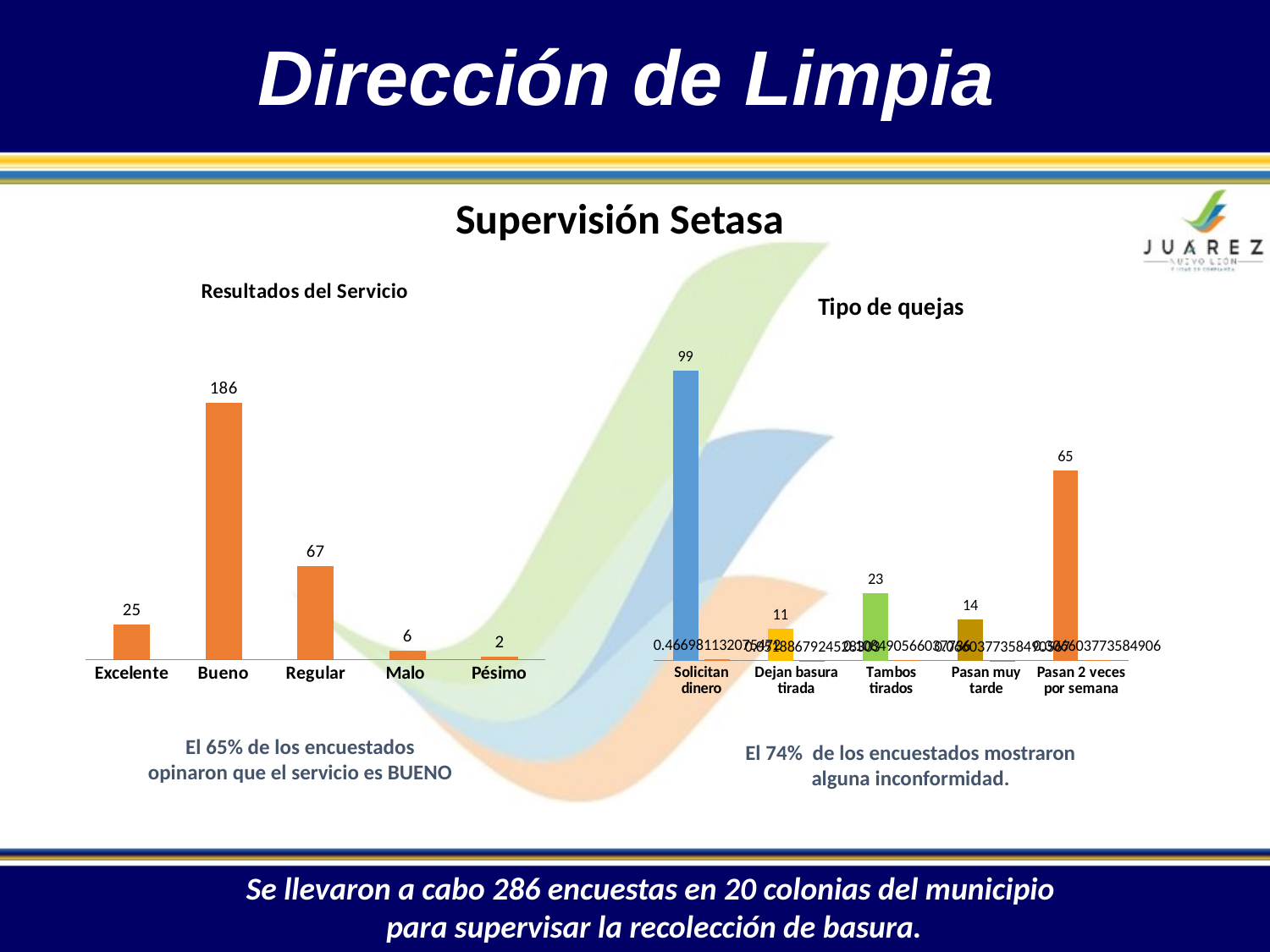
In the 'Resultados del Servicio' chart, what is the difference between the values for Bueno and Regular? 119 In the 'Resultados del Servicio' chart, what is the value for Bueno? 186 In the 'Tipo de quejas' chart, which category has the highest value? Solicitan dinero In the 'Tipo de quejas' chart, which is larger: Pasan muy tarde or Dejan basura tirada? Pasan muy tarde In the 'Tipo de quejas' chart, what is the value for Tambos tirados? 23 In the 'Resultados del Servicio' chart, which category has the highest value? Bueno In the 'Resultados del Servicio' chart, which category has the lowest value? Pésimo In the 'Resultados del Servicio' chart, how many categories are shown on the x axis? 5 In the 'Tipo de quejas' chart, what is the difference between the values for Solicitan dinero and Pasan 2 veces por semana? 34 What kind of chart is the 'Tipo de quejas' chart? Bar chart In the 'Resultados del Servicio' chart, what is the value for Regular? 67 In the 'Tipo de quejas' chart, what is the value for Solicitan dinero? 99